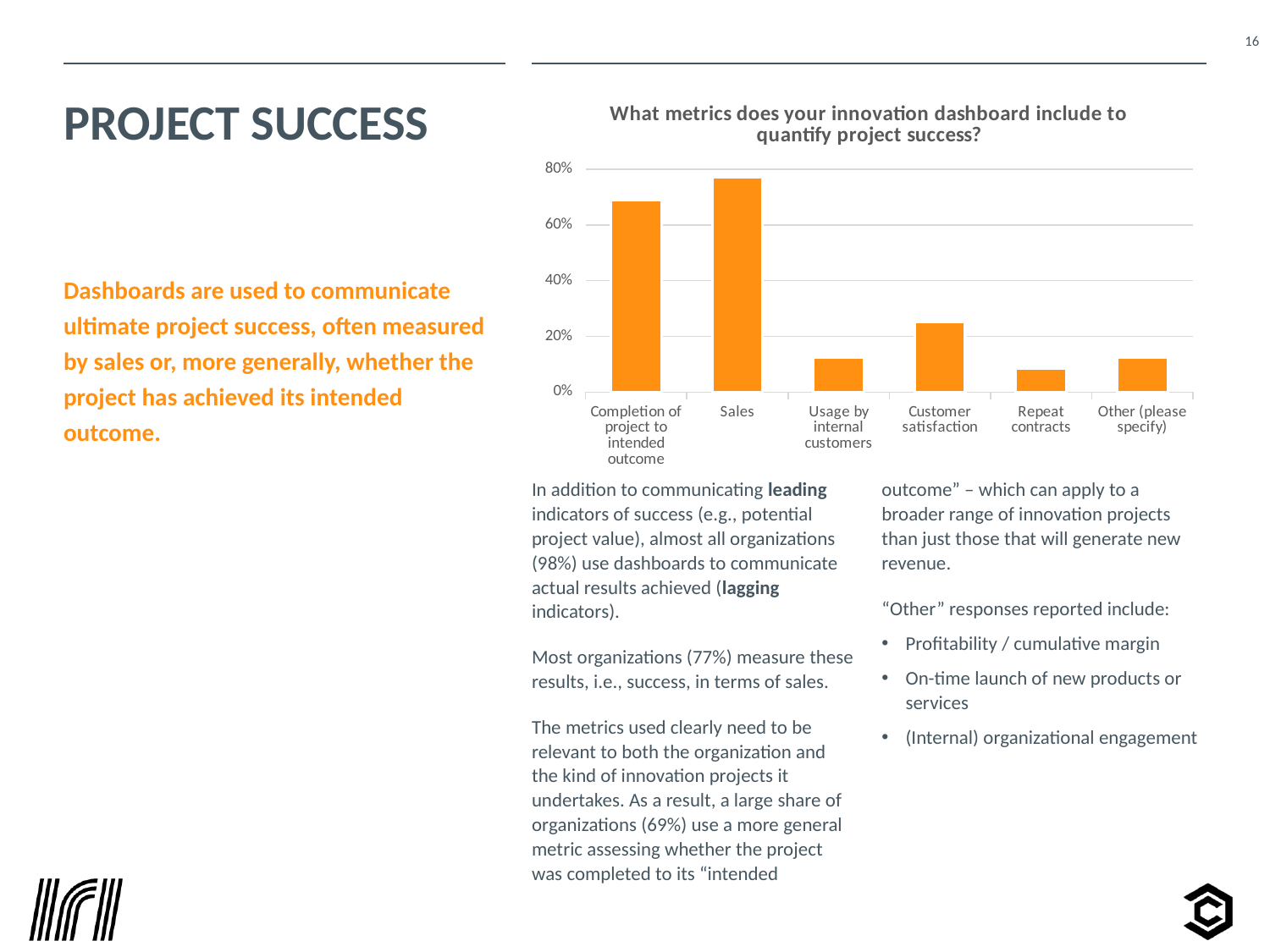
Which is larger: the value for Sales or the value for Completion of project to intended outcome? Sales Which metric has the highest value in the chart? Sales What colour are the bars in the chart? Orange Which is larger: the value for Customer satisfaction or the value for Usage by internal customers? Customer satisfaction How many categories are shown on the x axis of the chart? 6 What is the title of the chart? What metrics does your innovation dashboard include to quantify project success? Is the value for Sales greater or less than 60%? greater Is the value for Completion of project to intended outcome greater or less than 80%? less What kind of chart is shown on the slide? Bar chart Is the value for Repeat contracts greater or less than 20%? less Which metric has the lowest value in the chart? Repeat contracts